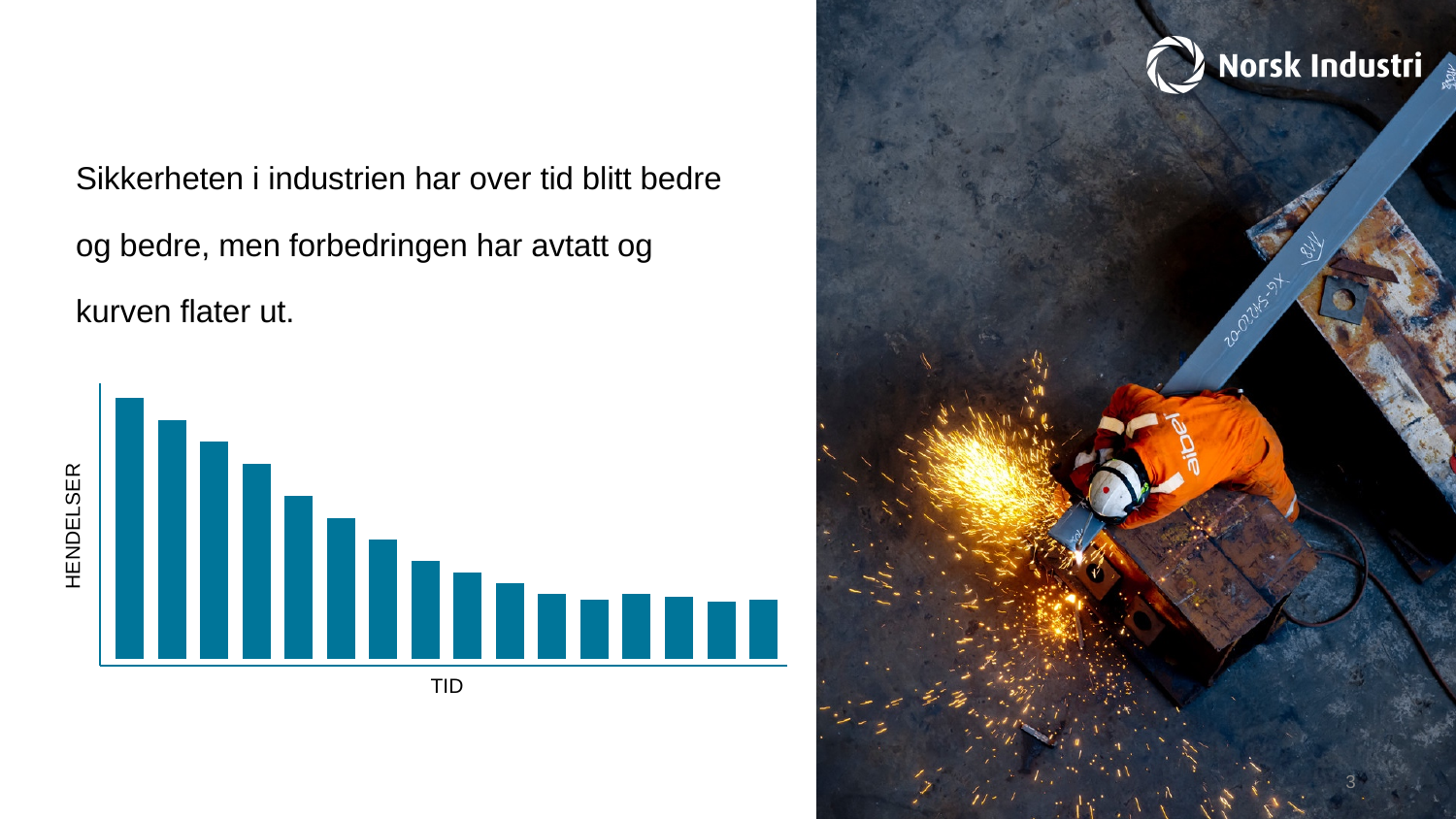
Do the bar values rise or fall from left to right along the x axis? fall What is the label on the vertical (y) axis of the chart? HENDELSER Which is larger, the second bar or the fifth bar? the second bar What is the label on the horizontal (x) axis of the chart? TID Which bar is the tallest in the chart? the leftmost (first) bar What kind of chart is shown on the slide? bar chart How many bars does the chart contain? 16 Which is larger, the first bar on the left or the last bar on the right? the first bar on the left